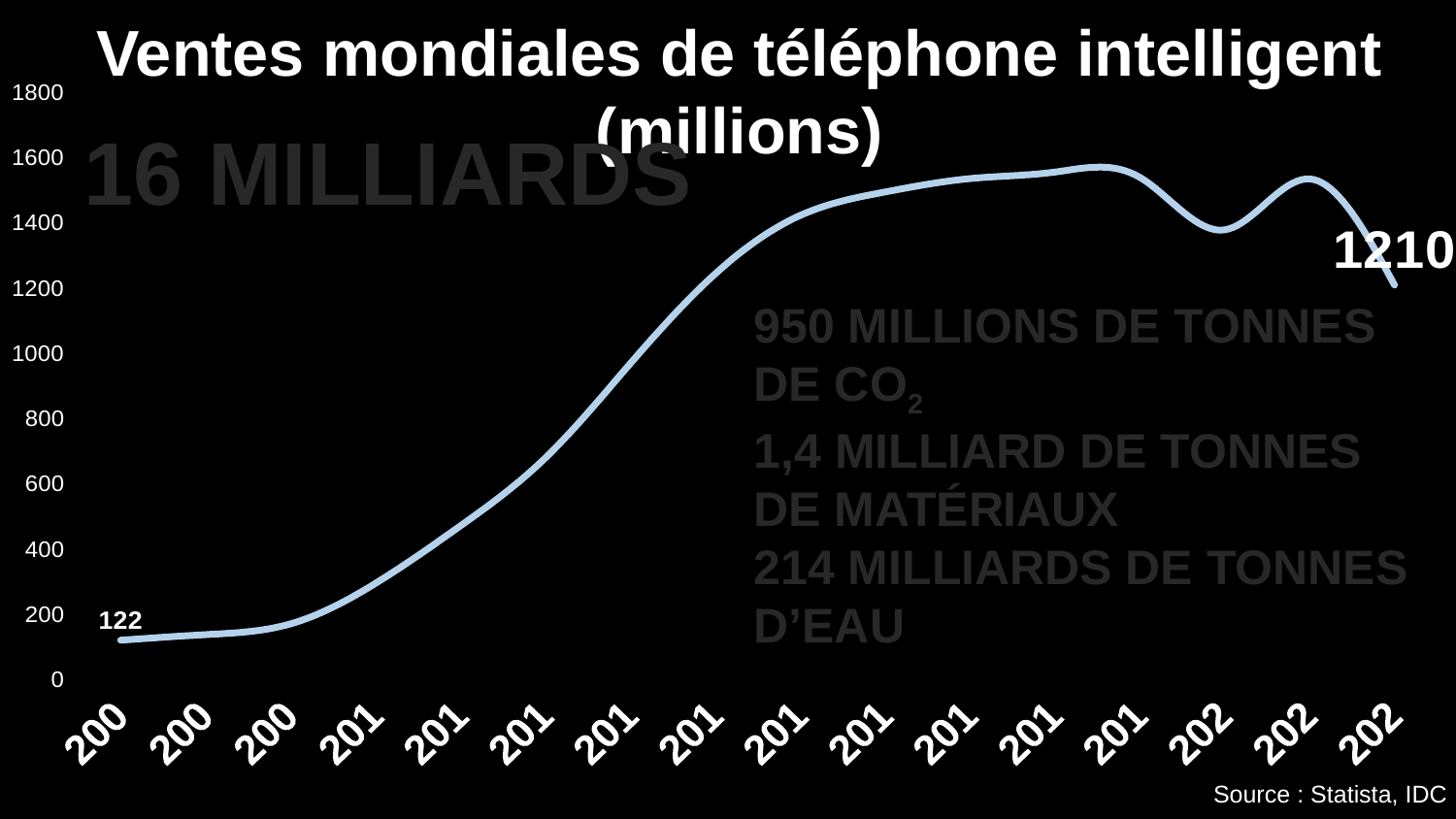
What is the value of the last data point on the line? 1210 What is the value of the first data point on the line? 122 What is the difference between the last data point (1210) and the first data point (122)? 1088 What is the title of the chart? Ventes mondiales de téléphone intelligent (millions) Is the last data point on the line greater or less than 1400? less Overall, do the values rise or fall from the left to the right of the x axis? rise Is the first data point on the line greater or less than 200? less Which is larger, the first data point or the last data point on the line? the last data point How many data points are plotted along the x axis? 16 What kind of chart is shown on the slide? line chart Is the highest point of the line greater or less than 1400? greater What is the maximum value shown on the y axis? 1800